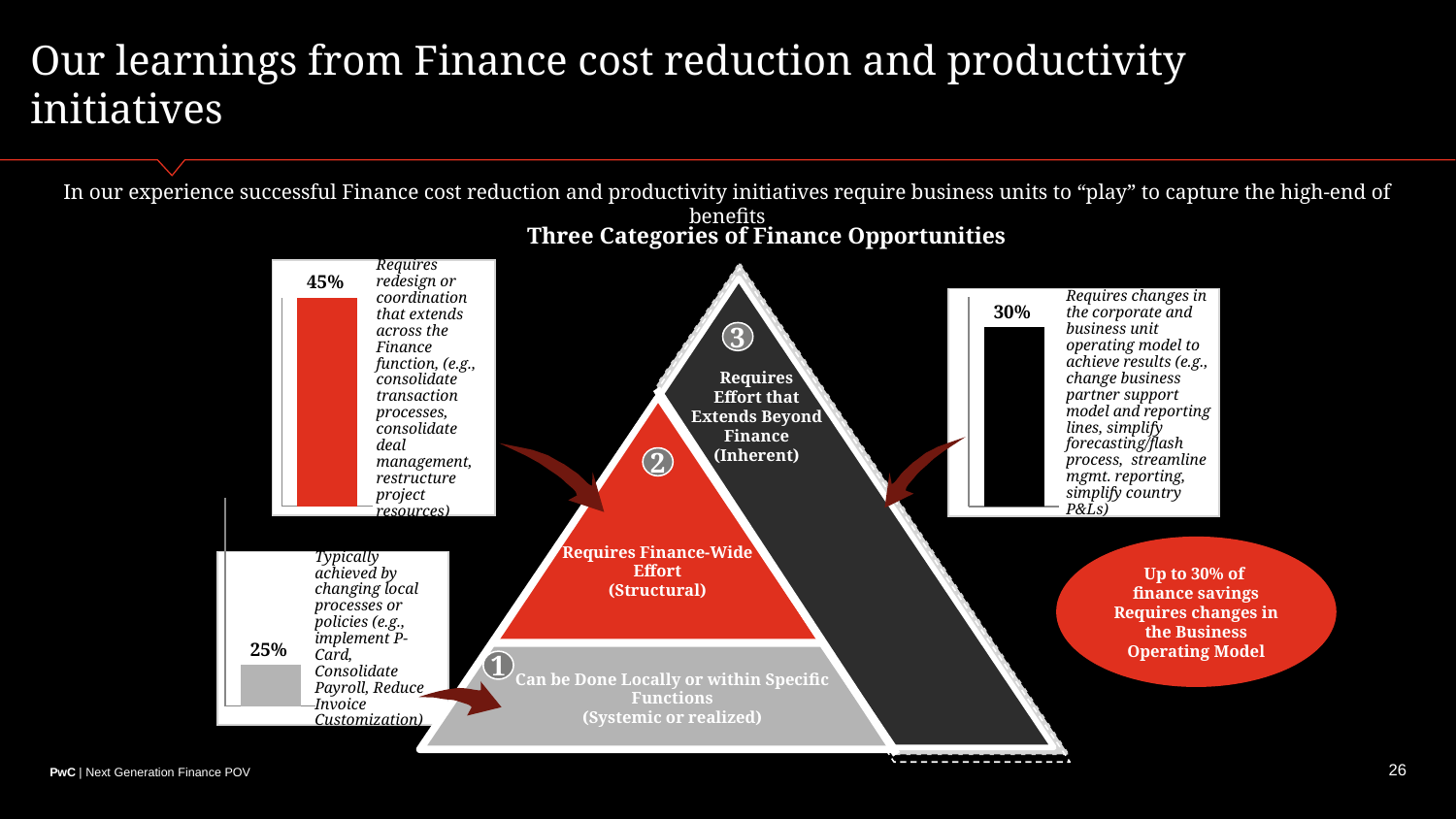
What is the difference between the value in the right-hand bar chart (30%) and the value in the bottom-left bar chart (25%)? 5% How many bars does the bar chart on the right side of the slide (showing 30%) contain? 1 Of the three small bar charts on the slide, which value is the highest? 45% In the bar chart at the bottom left of the slide (next to the text beginning "Typically achieved by changing local processes"), what value is shown on the bar? 25% Which is larger: the value in the top-left bar chart or the value in the bottom-left bar chart? The top-left bar chart (45%) What kind of chart is the small chart at the top left of the slide showing 45%? Bar chart Of the three small bar charts on the slide, which value is the lowest? 25% In the bar chart on the right side of the slide (next to the text beginning "Requires changes in the corporate and business unit operating model"), what value is shown on the bar? 30% What colour is the bar in the bottom-left bar chart showing 25%? Grey In the bar chart at the top left of the slide (next to the text beginning "Requires redesign or coordination"), what value is shown on the bar? 45% What colour is the bar in the top-left bar chart showing 45%? Red What is the difference between the value in the top-left bar chart (45%) and the value in the right-hand bar chart (30%)? 15%